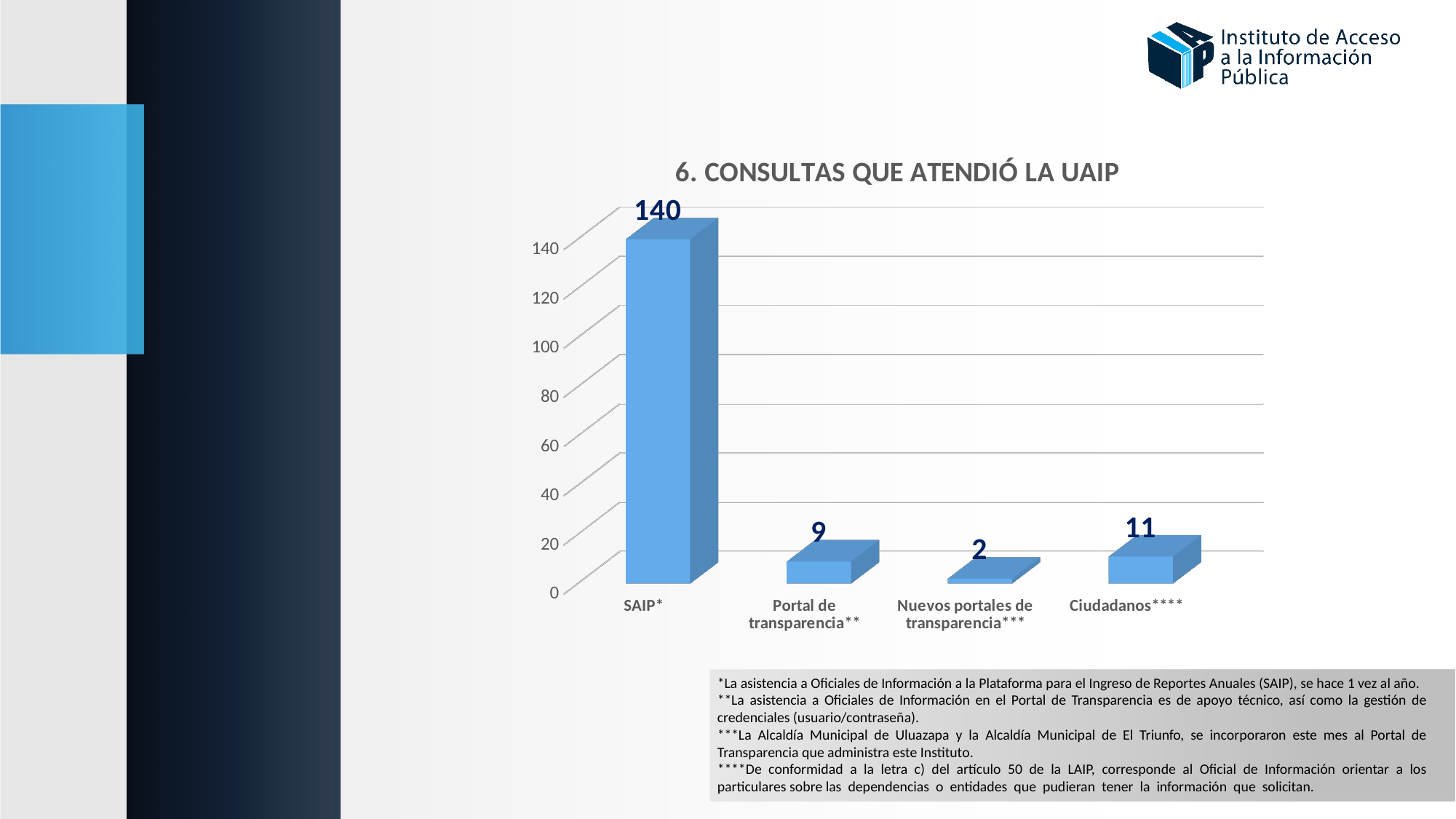
What is the value for SAIP*? 140 Which category has the lowest value? Nuevos portales de transparencia*** What is the value for Portal de transparencia**? 9 What is the title of the chart? 6. CONSULTAS QUE ATENDIÓ LA UAIP What is the difference between the values for Ciudadanos**** and Portal de transparencia**? 2 Which is larger, the value for Portal de transparencia** or the value for Ciudadanos****? Ciudadanos**** What is the difference between the values for SAIP* and Ciudadanos****? 129 What is the value for Nuevos portales de transparencia***? 2 Which category has the highest value? SAIP* What kind of chart is shown on the slide? Bar chart How many categories are shown on the chart? 4 What is the value for Ciudadanos****? 11